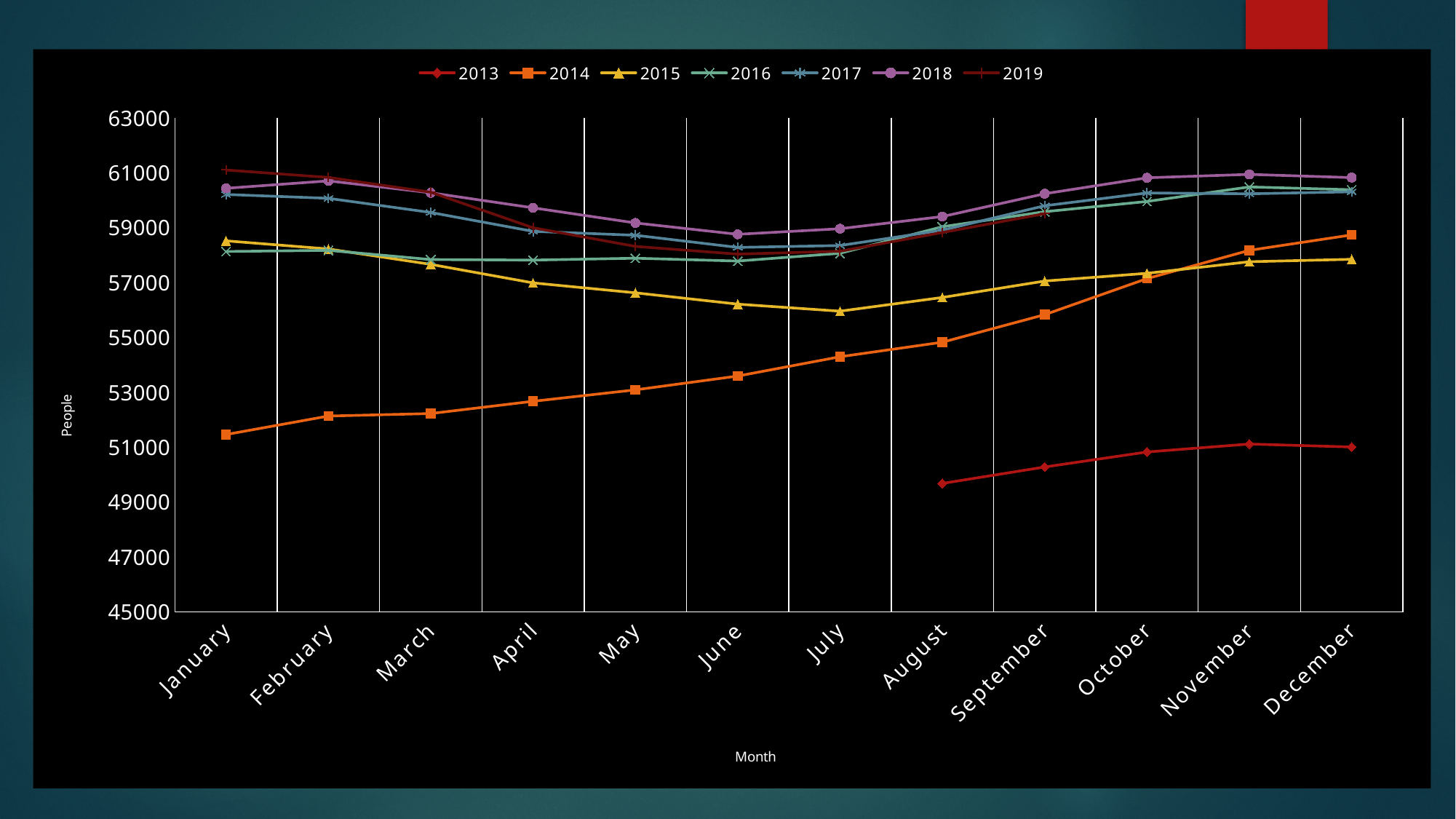
Does the 2014 series rise or fall from January to December? rise How many months are shown along the x axis? 12 Is the value for 2014 in January greater or less than 53000? less What is the title of the y axis? People Which series has the lowest value in December? 2013 In December, which series has the larger value, 2013 or 2014? 2014 How many series does the legend list? 7 Is the value for 2016 in June greater or less than 59000? less Is the value for 2018 in November greater or less than 59000? greater What kind of chart is shown on the slide? line chart